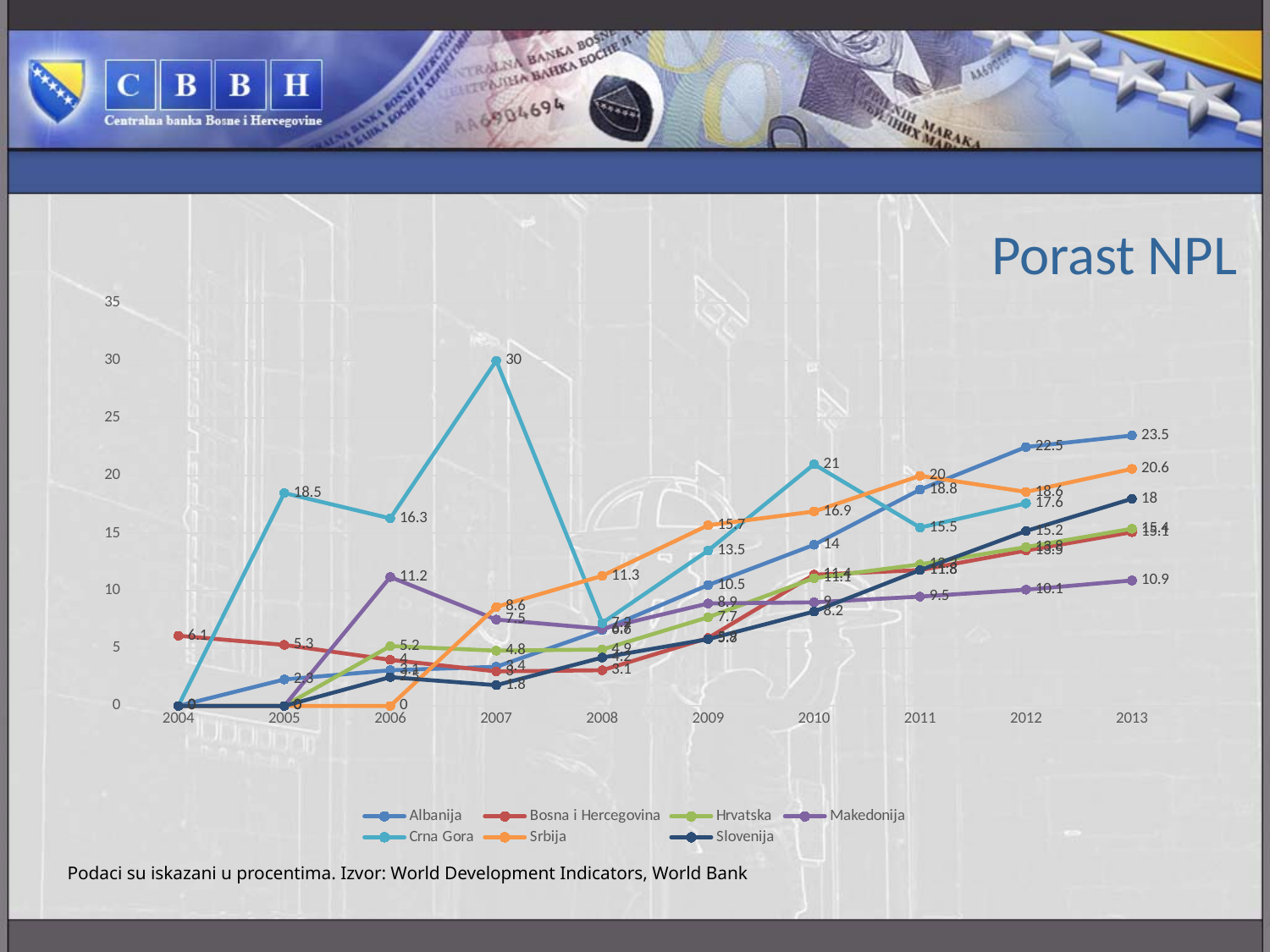
What is the value for Albanija in 2013? 23.5 What kind of chart is shown on the slide? Line chart What is the value for Crna Gora in 2007? 30 What is the value for Bosna i Hercegovina in 2004? 6.1 What is the difference between the values for Albanija and Srbija in 2013? 2.9 How many series does the legend list? 7 What is the title of the chart? Porast NPL What is the value for Srbija in 2013? 20.6 Which country has the highest value in 2013? Albanija What is the value for Makedonija in 2006? 11.2 Which country has the lowest value in 2013? Makedonija How many years are shown on the x axis? 10